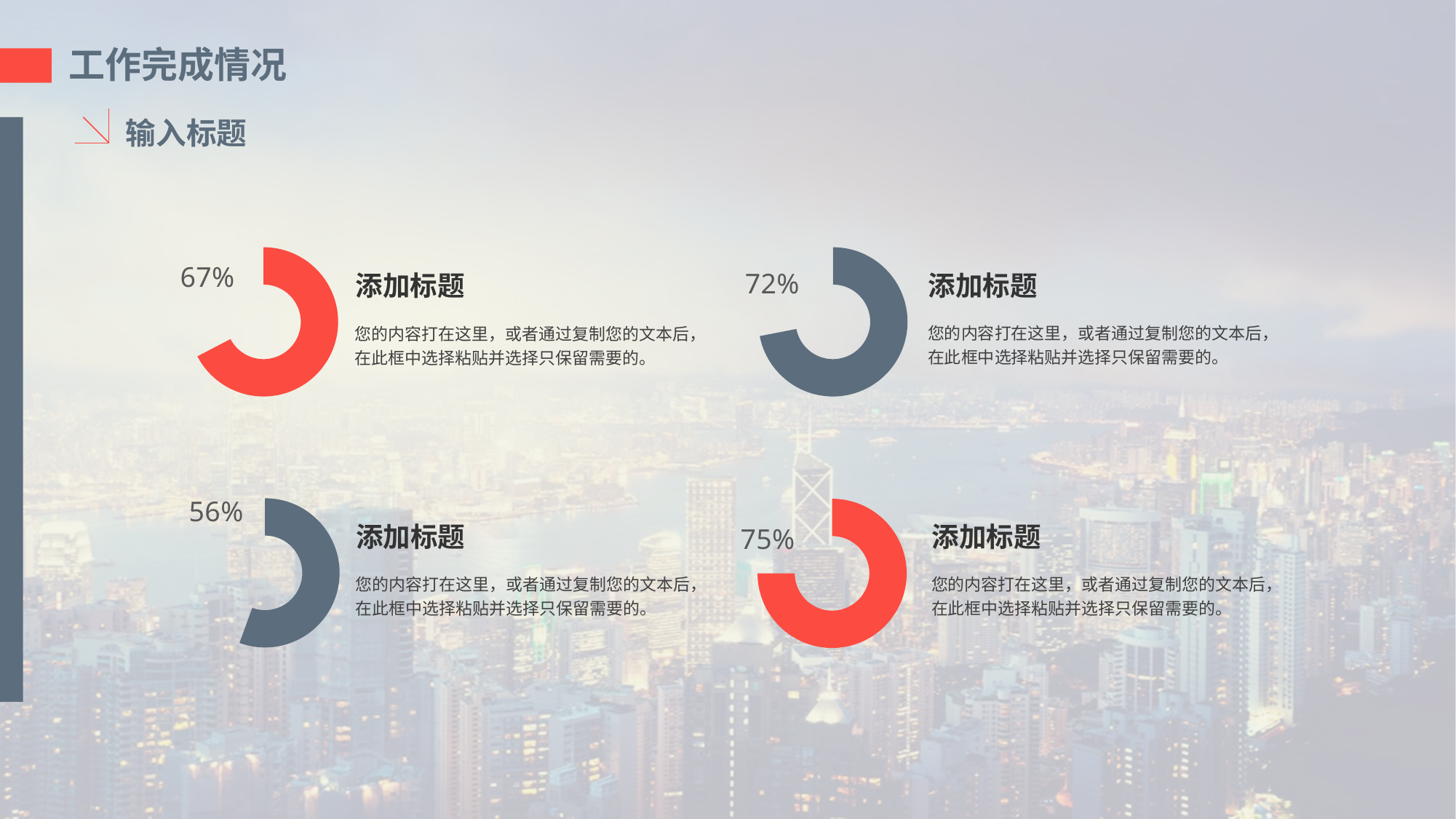
What is the difference between the percentages of the top-right and top-left donut charts? 5% What colour is the filled portion of the top-left donut chart? red What is the difference between the percentages of the bottom-right and bottom-left donut charts? 19% How many donut charts are on the slide? 4 What kind of chart is used to show the percentages on this slide? donut chart What percentage is shown next to the bottom-right donut chart? 75% Which of the four donut charts shows the highest percentage? bottom-right (75%) What percentage is shown next to the bottom-left donut chart? 56% What percentage is shown next to the top-right donut chart? 72% Which of the four donut charts shows the lowest percentage? bottom-left (56%) Which is larger, the percentage of the top-left donut chart or the top-right donut chart? top-right (72%) What percentage is shown next to the top-left donut chart? 67%